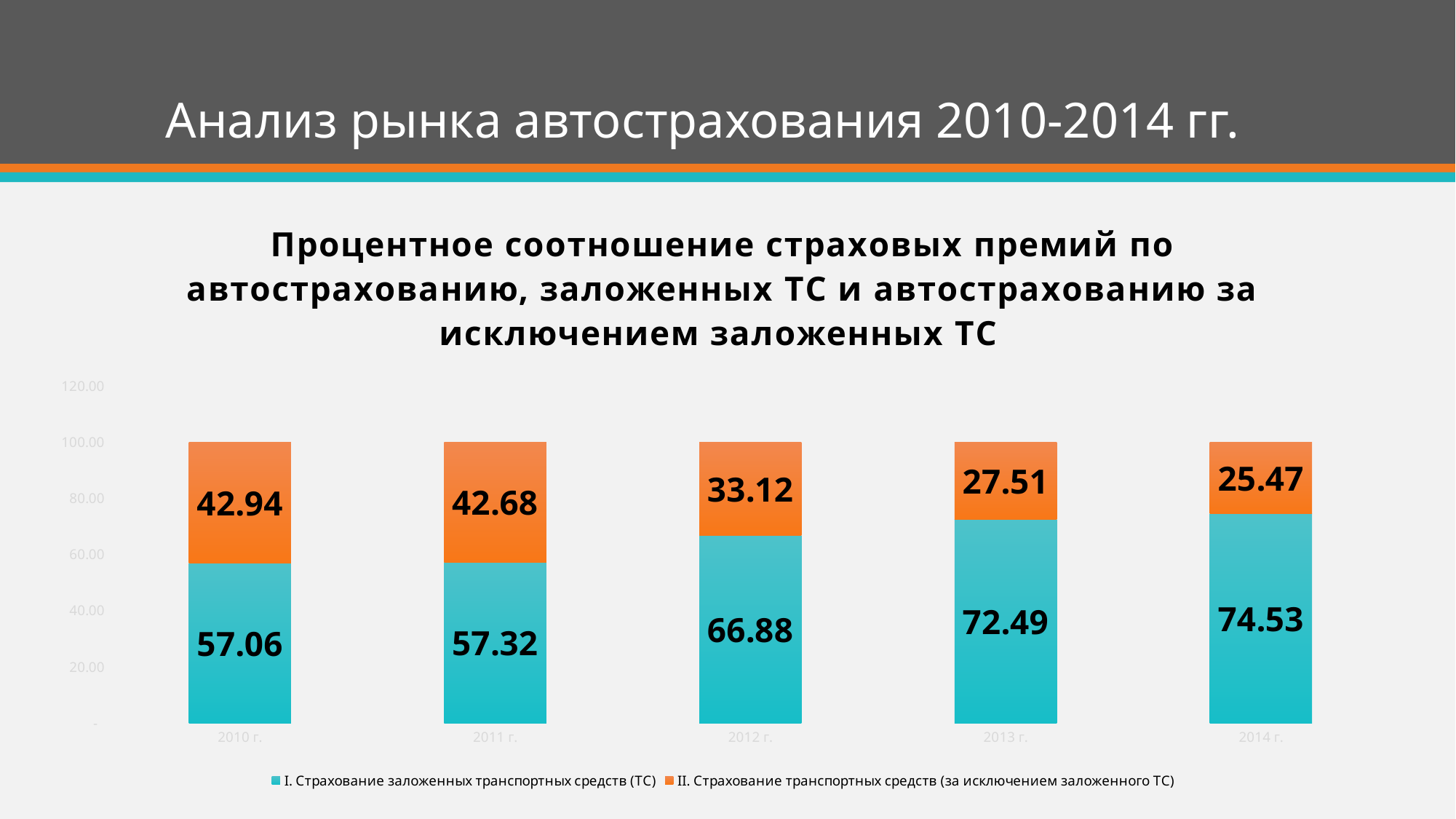
Which is larger in 2012 г.: the value for series I or the value for series II? Series I (66.88) What is the value for series II (Страхование транспортных средств (за исключением заложенного ТС)) in 2013 г.? 27.51 In which year is the value for series II (Страхование транспортных средств (за исключением заложенного ТС)) the lowest? 2014 г. In which year is the value for series I (Страхование заложенных транспортных средств (ТС)) the highest? 2014 г. What is the difference between the series I value in 2014 г. and the series I value in 2010 г.? 17.47 How many series does the legend list? 2 Does the value for series I (Страхование заложенных транспортных средств (ТС)) rise or fall from 2010 г. to 2014 г.? Rise What is the value for series I (Страхование заложенных транспортных средств (ТС)) in 2010 г.? 57.06 What is the total of the stacked bar for 2011 г.? 100.00 What is the value for series I (Страхование заложенных транспортных средств (ТС)) in 2014 г.? 74.53 How many years (categories) are shown on the x axis? 5 What kind of chart is shown on the slide? Stacked bar chart